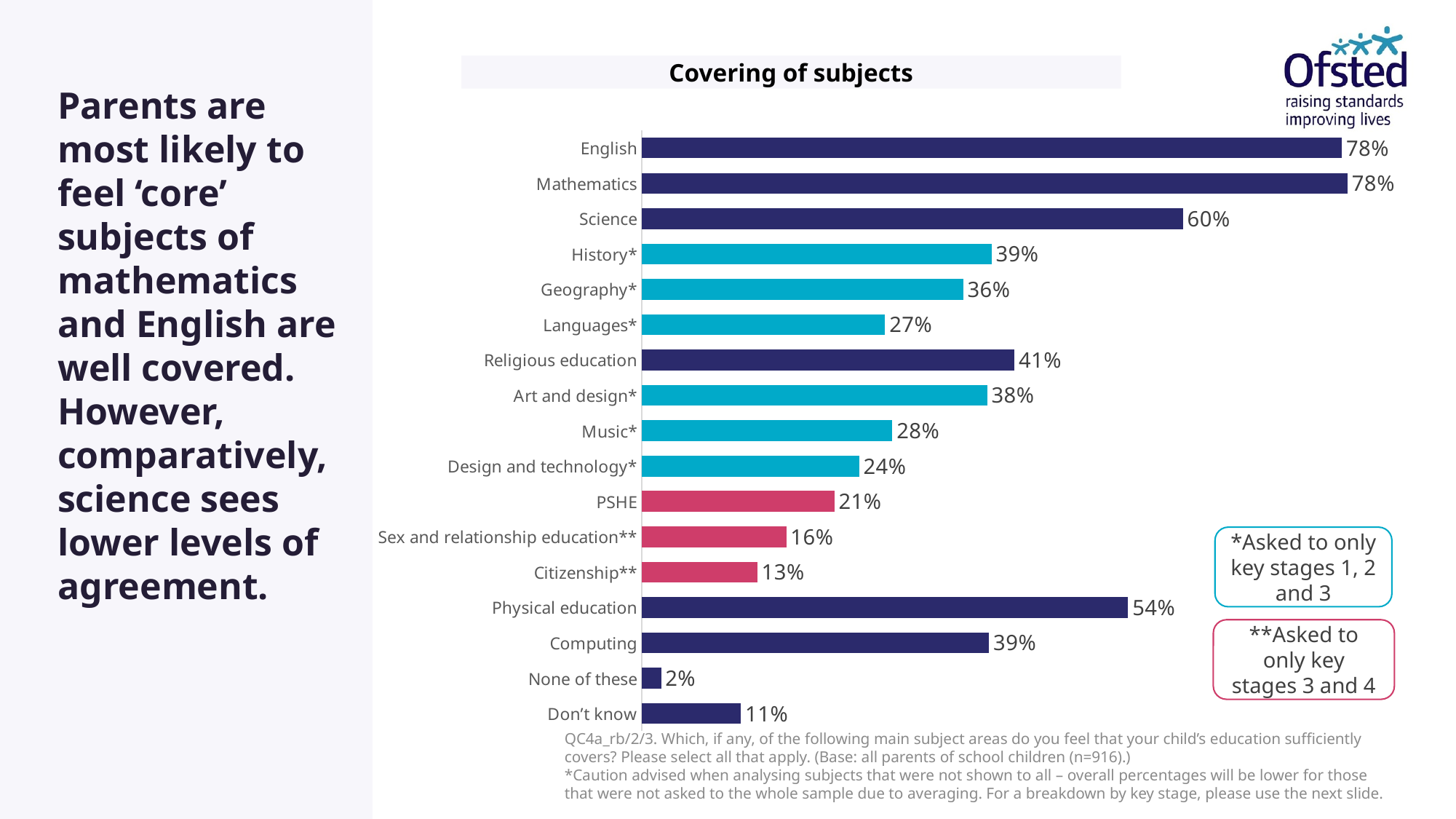
What kind of chart is shown on the slide? Bar chart What is the difference between the values for Science and Physical education? 6 percentage points Which category has the lowest value in the chart? None of these What is the value for Don't know? 11% Which has a higher value, Religious education or Art and design*? Religious education What is the title of the chart? Covering of subjects What percentage is shown for Physical education? 54% Which two categories share the highest value in the chart? English and Mathematics What is the value for Sex and relationship education**? 16% How many categories are plotted in the Covering of subjects chart? 17 What is the difference between the values for History* and Geography*? 3 percentage points What is the value for Science in the Covering of subjects chart? 60%